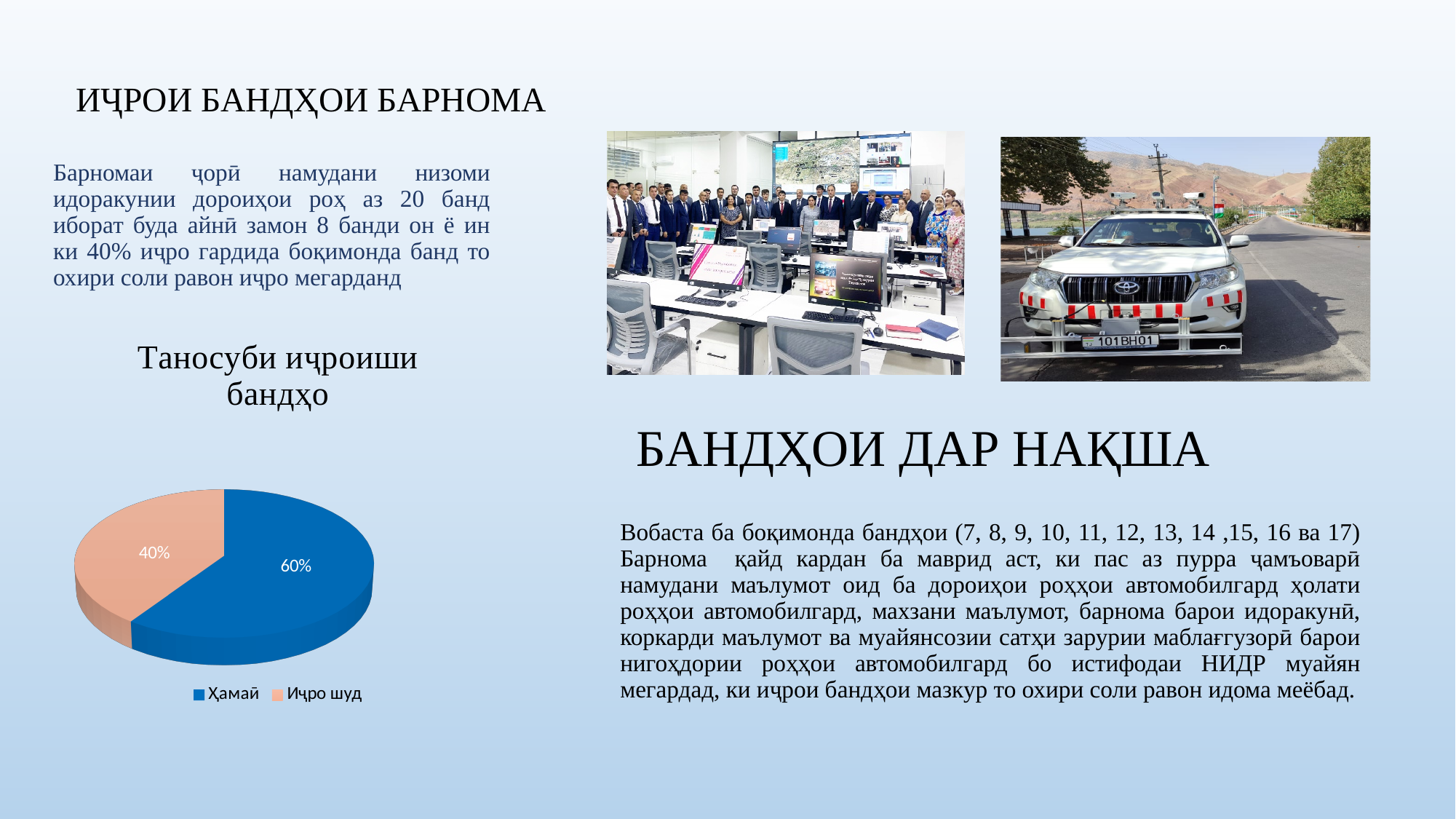
How many entries does the chart's legend list? 2 Which slice of the pie chart is the smallest? Иҷро шуд How many slices does the pie chart have? 2 What colour is the Иҷро шуд slice in the pie chart? peach (light orange) What share of the pie does the slice labelled Ҳамай represent? 60% What share of the pie does the slice labelled Иҷро шуд represent? 40% What kind of chart is shown on the slide? pie chart Which slice of the pie chart is the largest? Ҳамай What is the title of the chart on the slide? Таносуби иҷроиши бандҳо Which is larger, the Ҳамай slice or the Иҷро шуд slice? Ҳамай What is the difference in percentage points between the Ҳамай slice and the Иҷро шуд slice? 20%